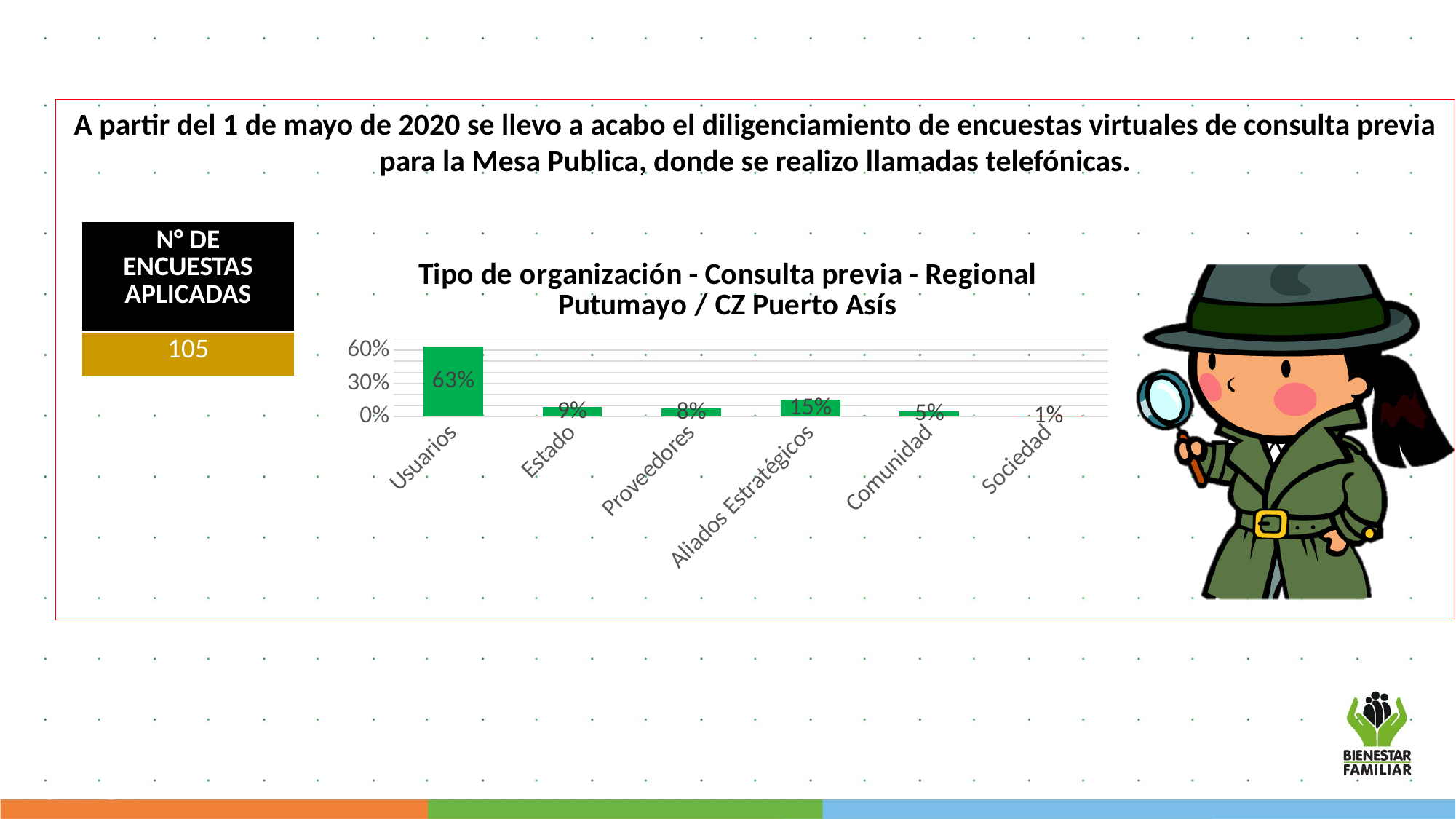
Which category has the highest value? Usuarios Which is larger, the value for Proveedores or the value for Comunidad? Proveedores What is the difference between the values for Usuarios and Aliados Estratégicos? 48% Which category has the lowest value? Sociedad How many categories are shown on the x axis? 6 What is the title of the chart? Tipo de organización - Consulta previa - Regional Putumayo / CZ Puerto Asís What kind of chart is shown? bar chart What is the value for Sociedad? 1% What is the value for Aliados Estratégicos? 15% Is the value for Usuarios greater or less than 30%? greater What is the value for Usuarios? 63% What is the value for Estado? 9%